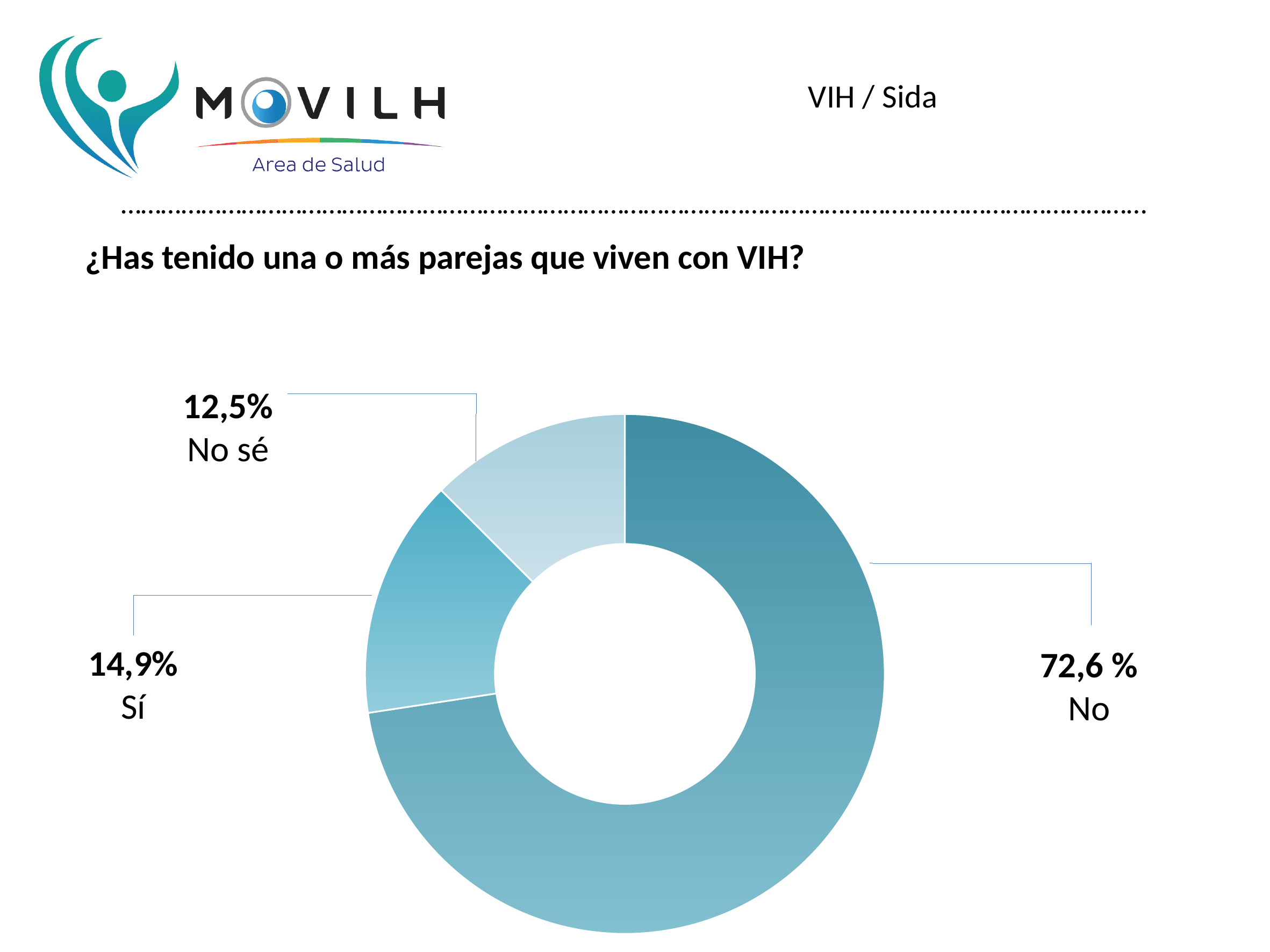
What is the difference in percentage points between "Sí" and "No sé"? 2,4 Which response has the largest share of the chart? No Which is larger, the share for "Sí" or the share for "No sé"? Sí What percentage of respondents answered "Sí"? 14,9% What percentage of respondents answered "No"? 72,6 % Which response has the smallest share of the chart? No sé What is the difference in percentage points between "No" and "Sí"? 57,7 What percentage of respondents answered "No sé"? 12,5% How many response categories does the chart show? 3 Which response is shown in the lightest shade of blue? No sé What kind of chart is shown on the slide? Doughnut (pie) chart What question does the chart answer, according to the slide title? ¿Has tenido una o más parejas que viven con VIH?